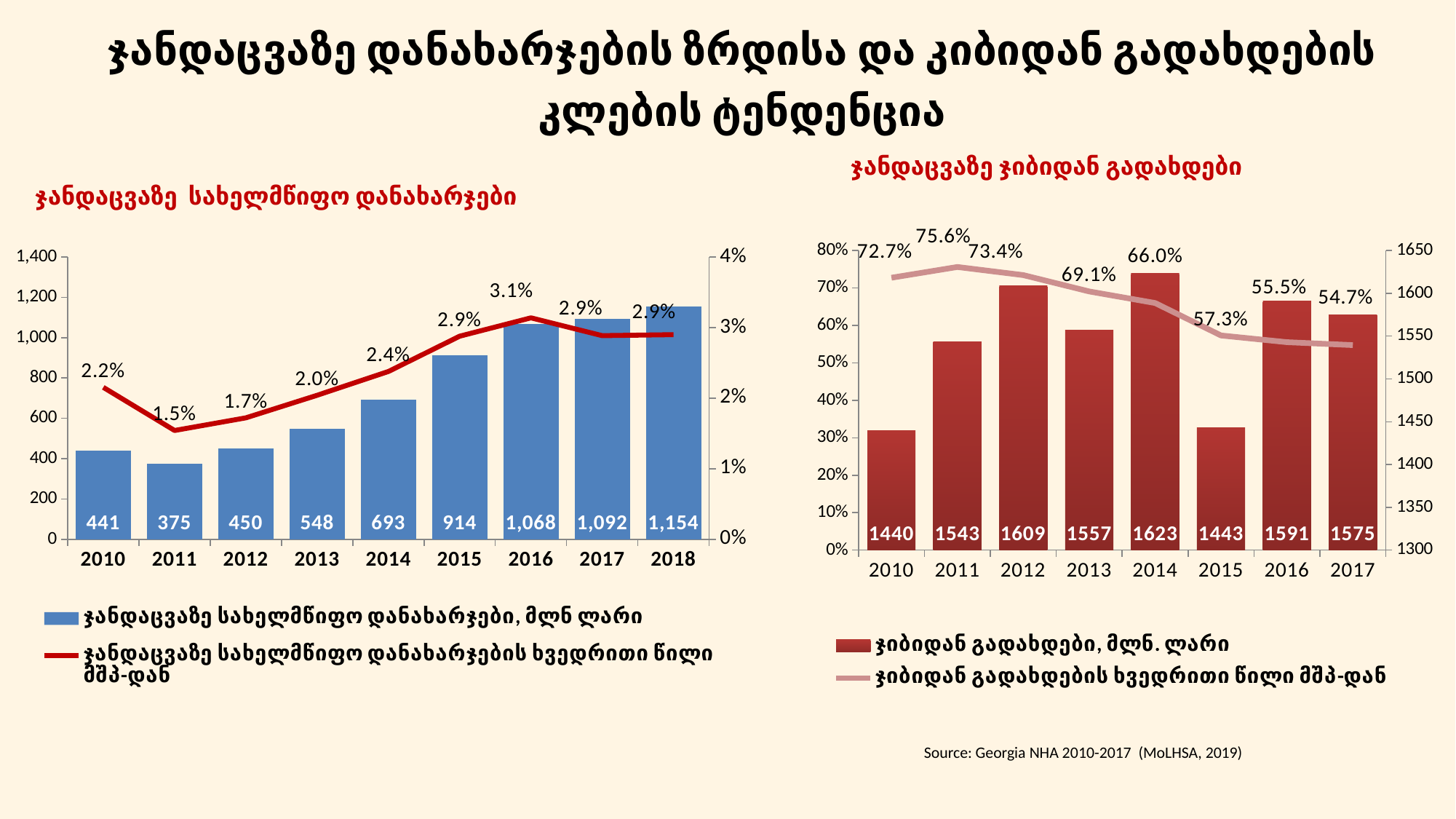
In the right chart, which is larger, the bar value for 2013 or for 2016? 2016 In the right chart, what is the value of the bar for 2012? 1609 In the right chart, does the line percentage rise or fall from 2011 to 2017? fall In the right chart, what percentage does the line show for 2015? 57.3% In the left chart, which year has the highest bar value? 2018 In the left chart, what is the difference between the bar values for 2018 and 2010? 713 How many years are shown on the x axis of the left chart? 9 In the left chart, which year has the lowest bar value? 2011 In the left chart, what is the value of the bar for 2014? 693 How many series does the legend of the right chart list? 2 In the left chart, what percentage does the line show for 2016? 3.1% In the right chart, which year has the highest bar value? 2014